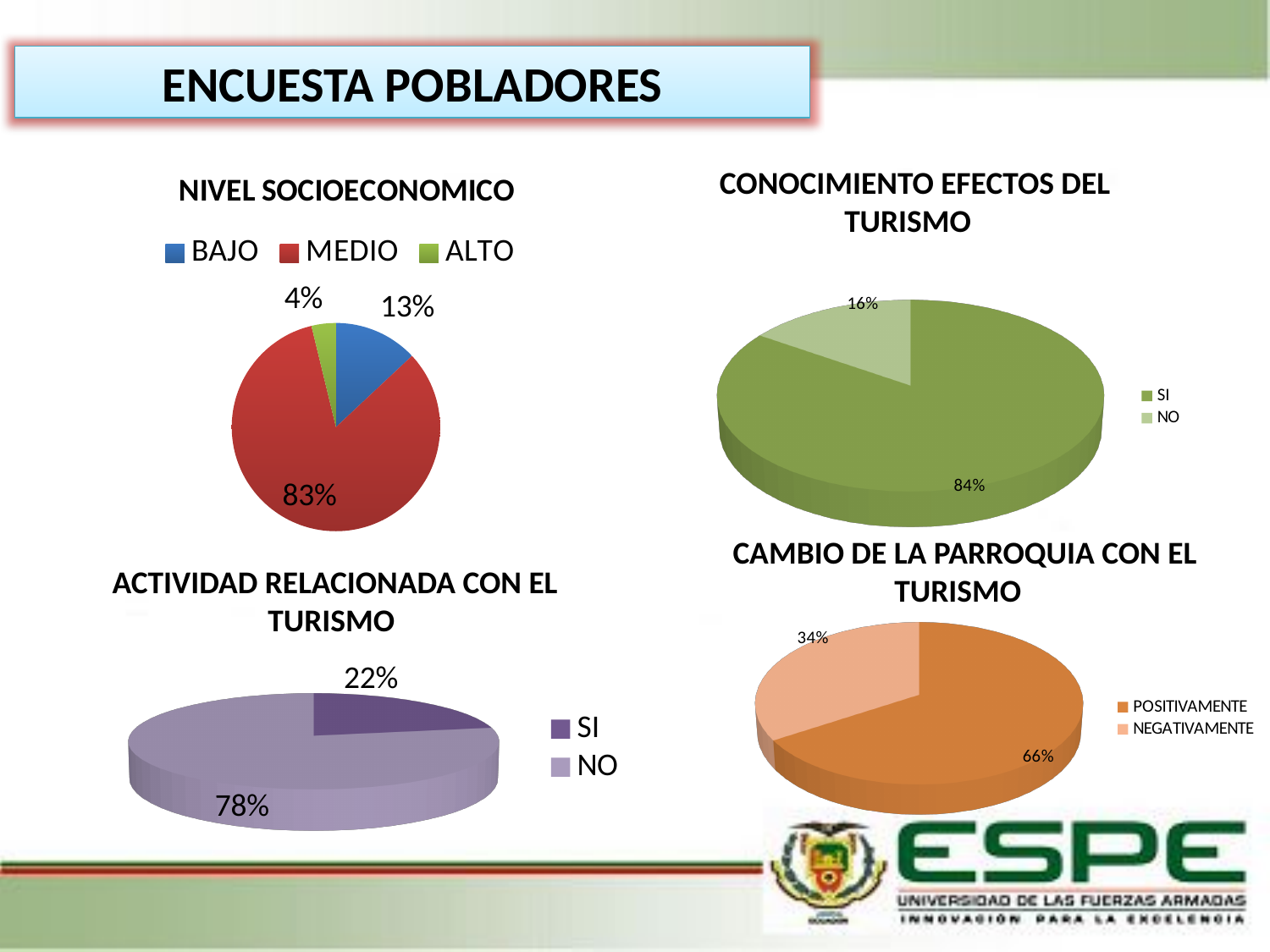
In the ACTIVIDAD RELACIONADA CON EL TURISMO chart, what is the difference between the NO and SI shares? 56% How many categories does the NIVEL SOCIOECONOMICO chart show? 3 What type of chart is the ACTIVIDAD RELACIONADA CON EL TURISMO chart? Pie chart In the NIVEL SOCIOECONOMICO chart, what is the difference between the BAJO and ALTO shares? 9% In the CAMBIO DE LA PARROQUIA CON EL TURISMO chart, what percentage is NEGATIVAMENTE? 34% In the NIVEL SOCIOECONOMICO chart, which category has the smallest share? ALTO In the ACTIVIDAD RELACIONADA CON EL TURISMO chart, what percentage answered NO? 78% In the NIVEL SOCIOECONOMICO chart, what percentage is MEDIO? 83% In the CONOCIMIENTO EFECTOS DEL TURISMO chart, which answer has the larger share, SI or NO? SI In the CONOCIMIENTO EFECTOS DEL TURISMO chart, what percentage answered SI? 84% In the CAMBIO DE LA PARROQUIA CON EL TURISMO chart, which category has the largest share? POSITIVAMENTE How many entries does the legend of the CAMBIO DE LA PARROQUIA CON EL TURISMO chart list? 2